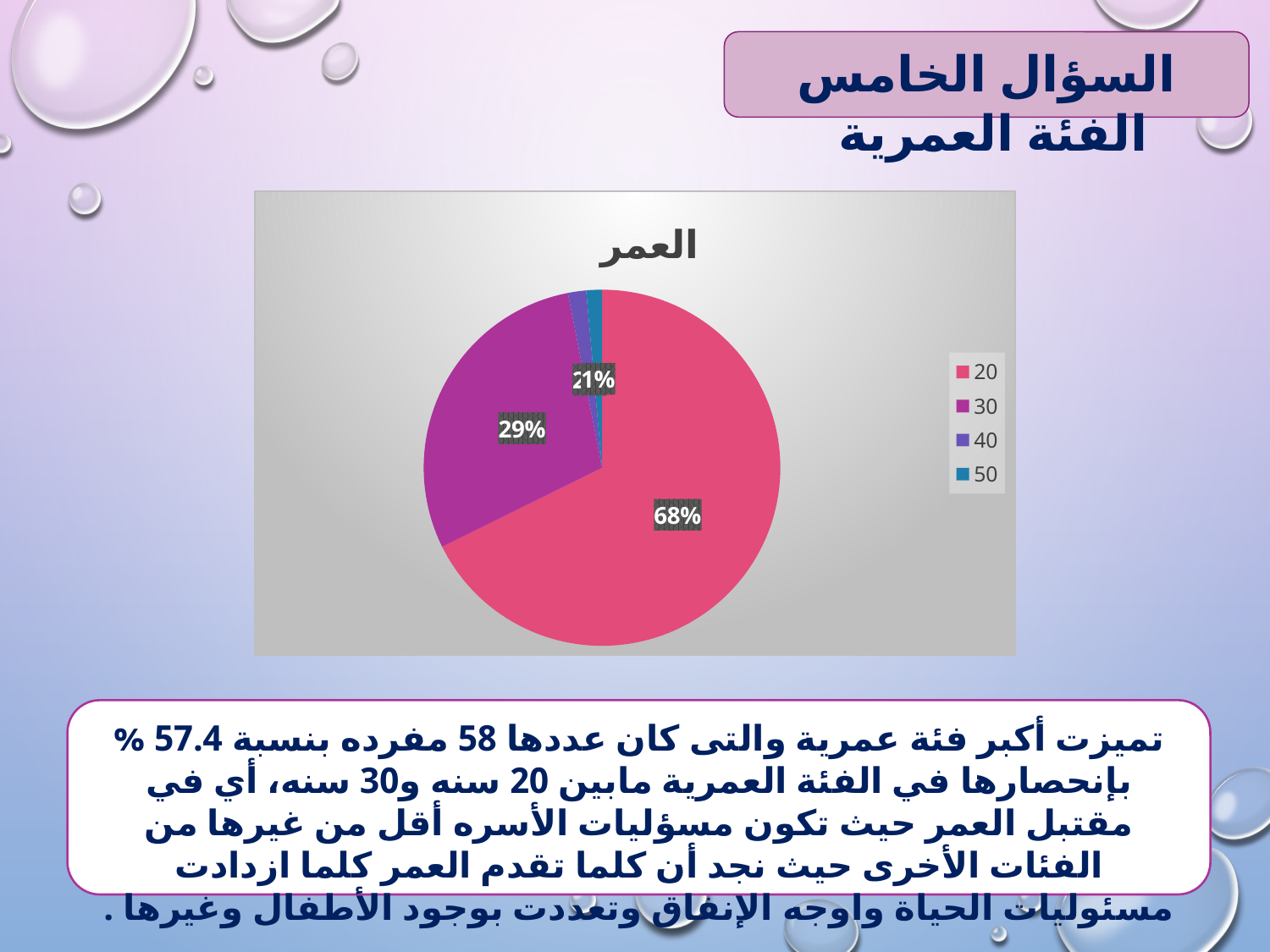
What type of chart is shown on the slide? Pie chart What percentage of the pie chart is the slice for the 20 age group? 68% How many categories does the legend of the pie chart list? 4 Which age group is shown in pink in the pie chart? 20 What is the title of the pie chart? العمر What percentage of the pie chart is the slice for the 30 age group? 29% What is the difference in percentage points between the 20 slice and the 30 slice? 39 Which age group has the largest slice in the pie chart? 20 Is the share for the 30 age group greater or less than 50%? less Which slice is larger, the one for 20 or the one for 30? 20 Is the share for the 20 age group greater or less than 50%? greater